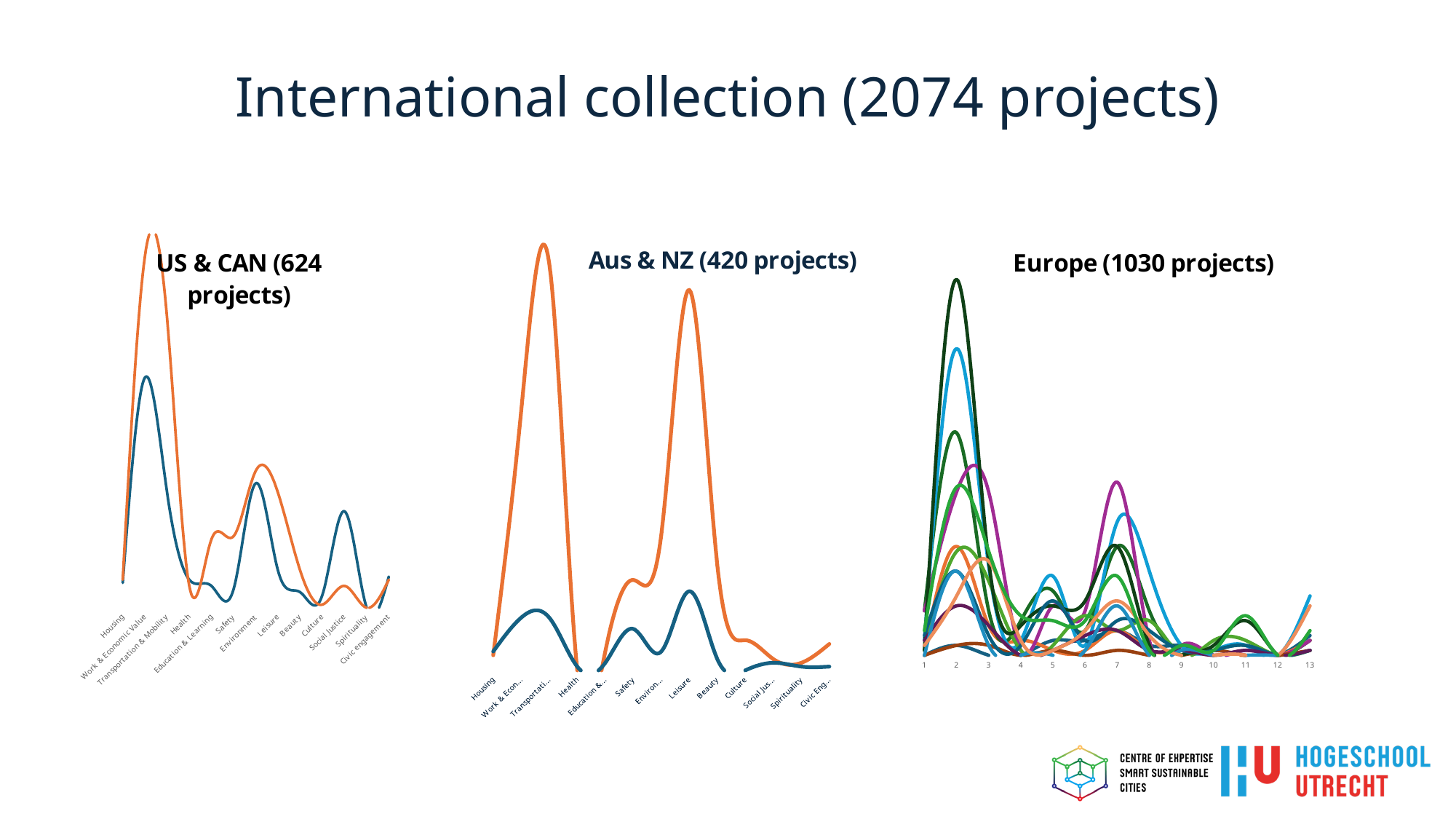
What kind of chart is the 'Europe (1030 projects)' chart? line chart In the 'Aus & NZ (420 projects)' chart, how many categories are shown on the x axis? 13 What kind of chart is the 'US & CAN (624 projects)' chart? line chart In the 'Europe (1030 projects)' chart, at which x-axis value does the highest peak of any line occur? 2 In the 'Aus & NZ (420 projects)' chart, is the orange line higher at Work & Econ... or at Leisure? Leisure How many projects does the title of the middle chart say are in the Aus & NZ collection? 420 projects In the 'US & CAN (624 projects)' chart, at which category does the blue line reach its highest point? Work & Economic Value In the 'US & CAN (624 projects)' chart, how many categories are shown on the x axis? 13 In the 'Aus & NZ (420 projects)' chart, at which category does the blue line reach its highest point? Leisure In the 'Europe (1030 projects)' chart, how many points are labelled on the x axis? 13 How many projects does the slide title say are in the international collection? 2074 projects